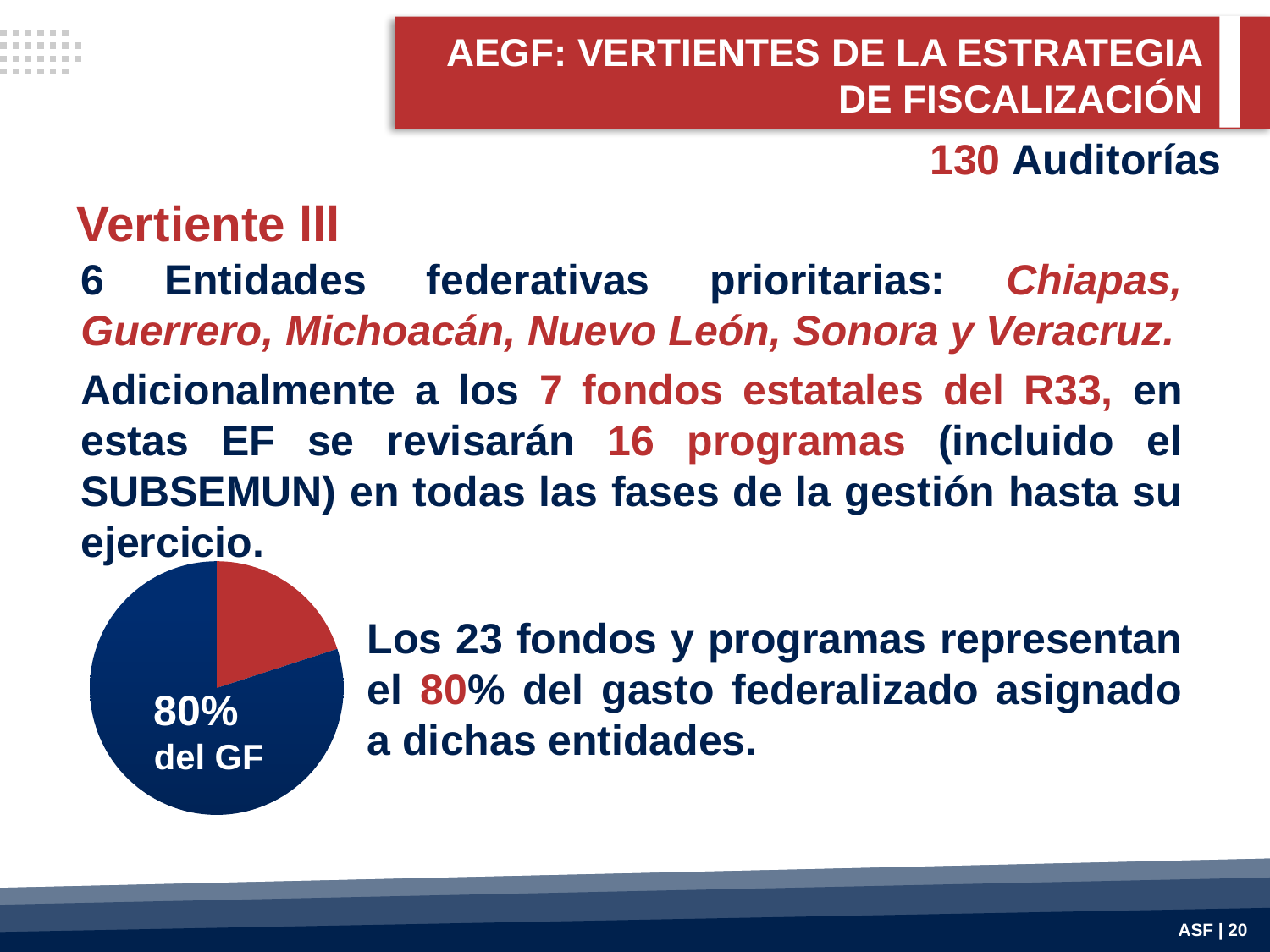
What kind of chart is shown on the slide? pie chart Which slice of the pie chart is the smallest? the red slice How many slices does the pie chart have? 2 Which slice of the pie chart is larger, the blue one or the red one? the blue one Is the blue slice of the pie chart greater or less than 50% of the pie? greater What colour is the slice labelled 80% del GF? blue According to the text next to the pie chart, how many fondos y programas represent 80% of the gasto federalizado? 23 What share of the pie does the blue slice represent? 80% What percentage is printed on the blue slice of the pie chart? 80% What label accompanies the 80% value on the pie chart? del GF Is the red slice of the pie chart greater or less than 50% of the pie? less Which slice of the pie chart is the largest? the blue slice